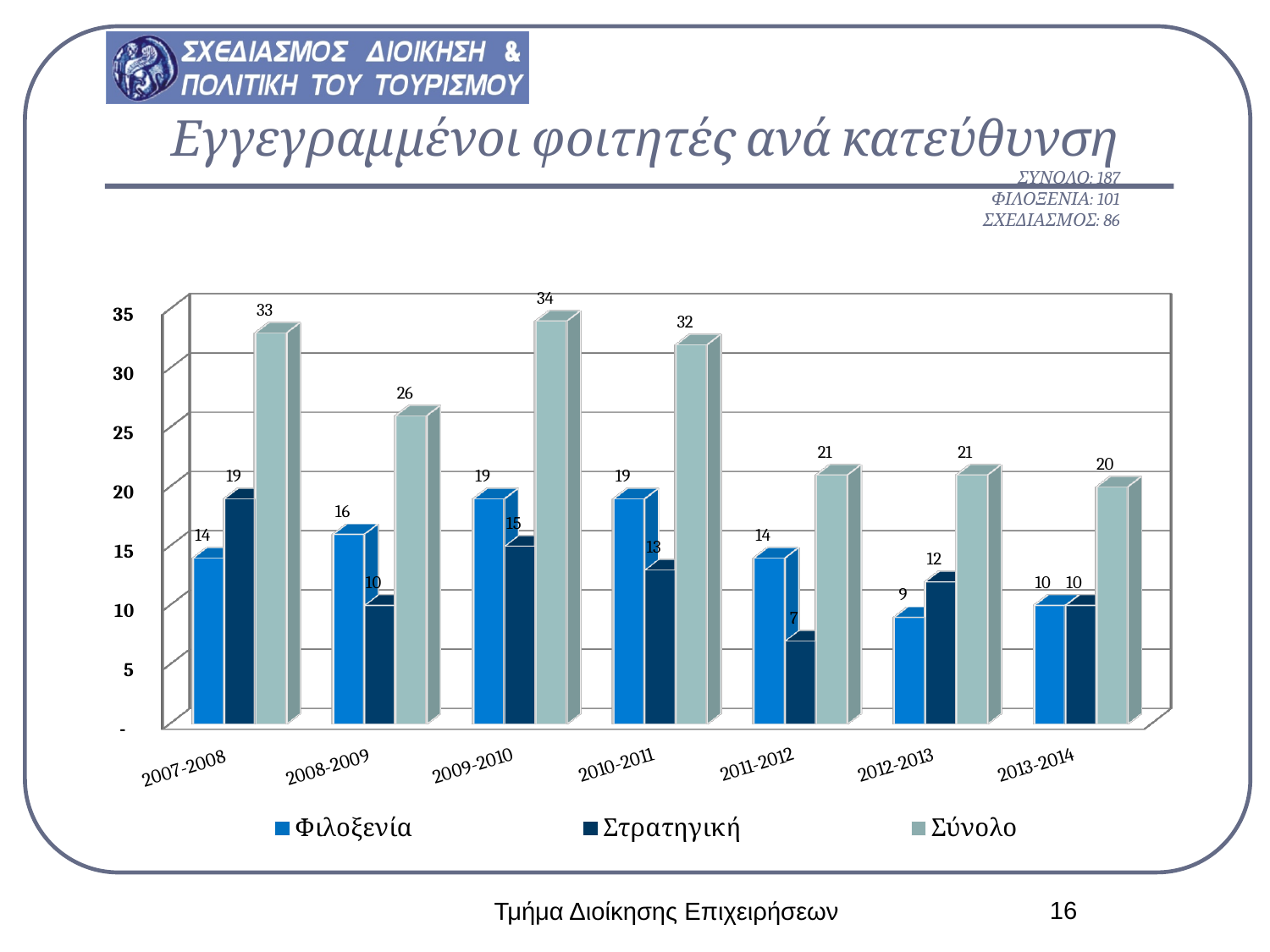
What is the title of the chart? Εγγεγραμμένοι φοιτητές ανά κατεύθυνση What is the difference between the Σύνολο values for 2007-2008 and 2008-2009? 7 What is the value for Σύνολο in 2010-2011? 32 In which academic year is the Φιλοξενία value lowest? 2012-2013 How many series does the legend list? 3 What is the value for Φιλοξενία in 2008-2009? 16 What kind of chart is shown on the slide? bar chart How many academic years are shown on the x axis? 7 Which is larger in 2012-2013, Φιλοξενία or Στρατηγική? Στρατηγική What is the value for Στρατηγική in 2011-2012? 7 In which academic year is the Σύνολο value highest? 2009-2010 Does the Σύνολο value rise or fall from 2010-2011 to 2013-2014? fall